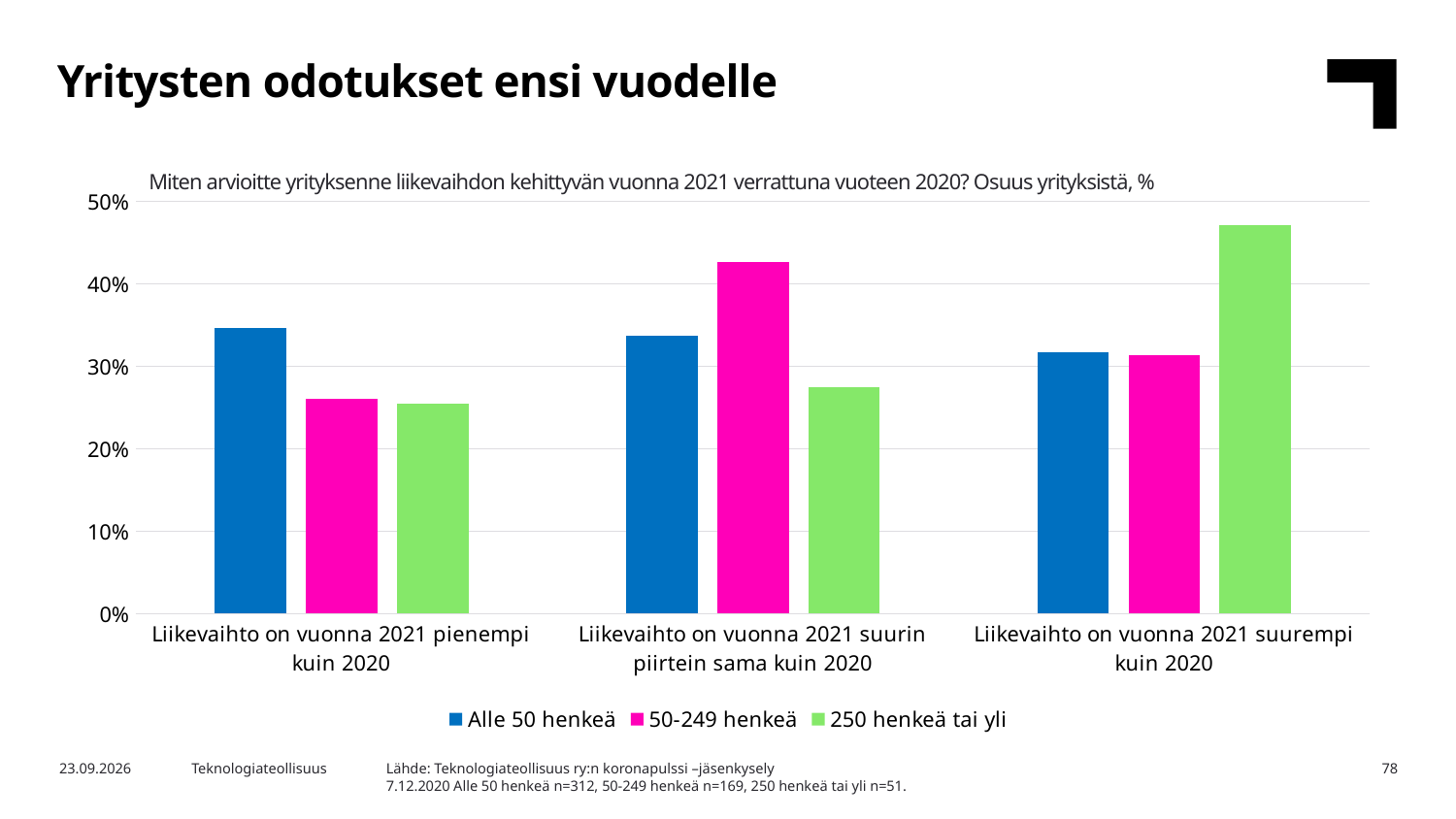
Is the value for 50-249 henkeä in the category 'Liikevaihto on vuonna 2021 suurin piirtein sama kuin 2020' greater or less than 40%? greater How many series does the legend list? 3 How many categories are shown on the x axis? 3 In the category 'Liikevaihto on vuonna 2021 suurin piirtein sama kuin 2020', which series has the lowest value? 250 henkeä tai yli In the category 'Liikevaihto on vuonna 2021 pienempi kuin 2020', which is larger: Alle 50 henkeä or 250 henkeä tai yli? Alle 50 henkeä In the category 'Liikevaihto on vuonna 2021 suurin piirtein sama kuin 2020', which is larger: Alle 50 henkeä or 50-249 henkeä? 50-249 henkeä Is the value for 250 henkeä tai yli in the category 'Liikevaihto on vuonna 2021 suurempi kuin 2020' greater or less than 40%? greater Is the value for Alle 50 henkeä in the category 'Liikevaihto on vuonna 2021 pienempi kuin 2020' greater or less than 30%? greater What kind of chart is shown on the slide? Bar chart Which series has the highest bar in the whole chart, and in which category? 250 henkeä tai yli, in Liikevaihto on vuonna 2021 suurempi kuin 2020 Which colour represents the series 50-249 henkeä in the legend? Pink (magenta)